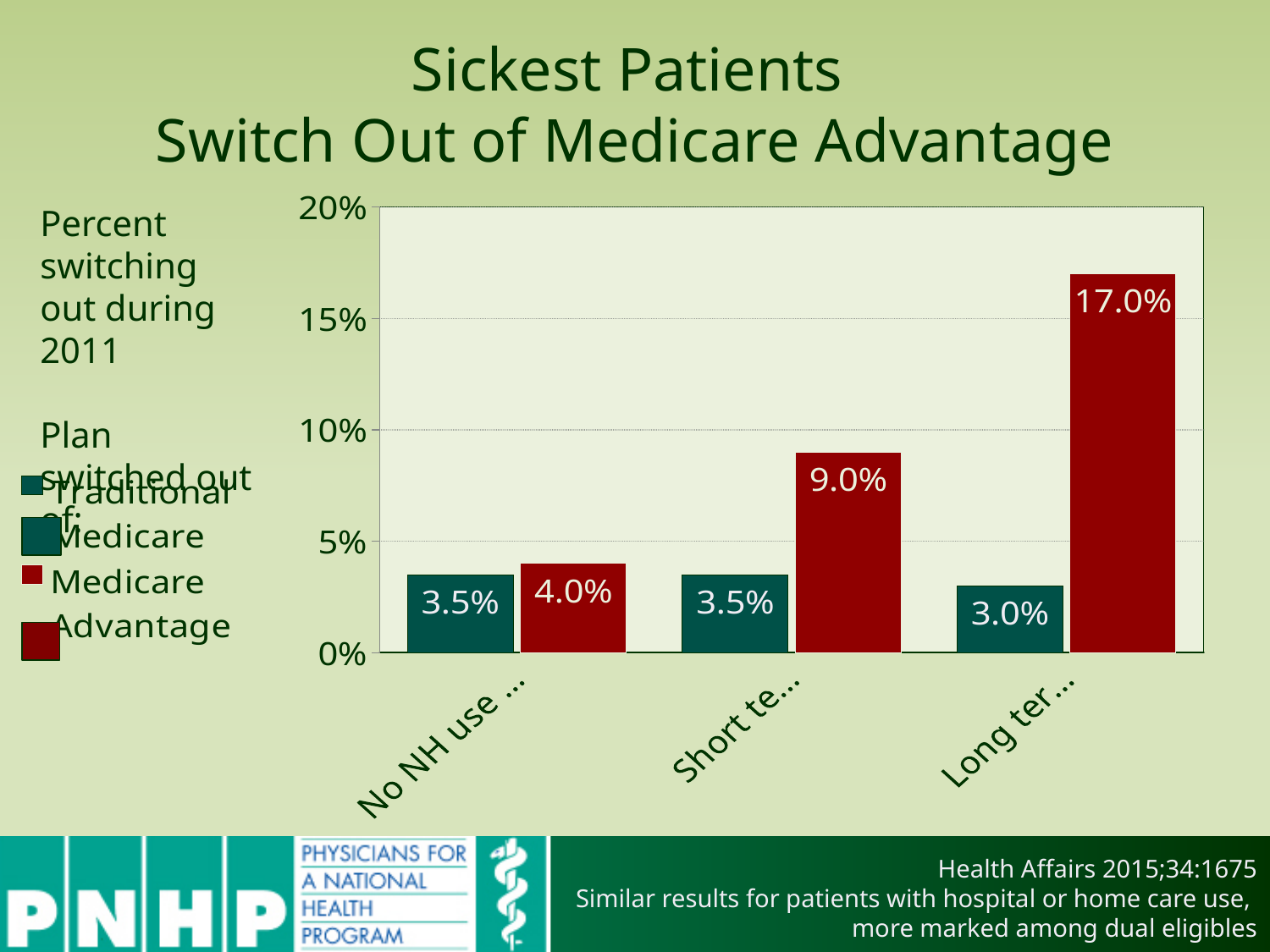
What type of chart is shown on the slide? bar chart How many series does the legend list? 2 Which series is shown in dark red? Medicare Advantage For the second category (Short te...), which is larger: Traditional Medicare or Medicare Advantage? Medicare Advantage How many categories are shown along the x axis? 3 Which category has the lowest Traditional Medicare value? Long ter... What is the Medicare Advantage value for the second category (Short te...)? 9.0% What is the Traditional Medicare value for the third category (Long ter...)? 3.0% Which category has the highest Medicare Advantage value? Long ter... What is the Medicare Advantage value for the third category (Long ter...)? 17.0% What is the difference between the Medicare Advantage and Traditional Medicare values for the third category (Long ter...)? 14.0% What is the Traditional Medicare value for the first category (No NH use ...)? 3.5%